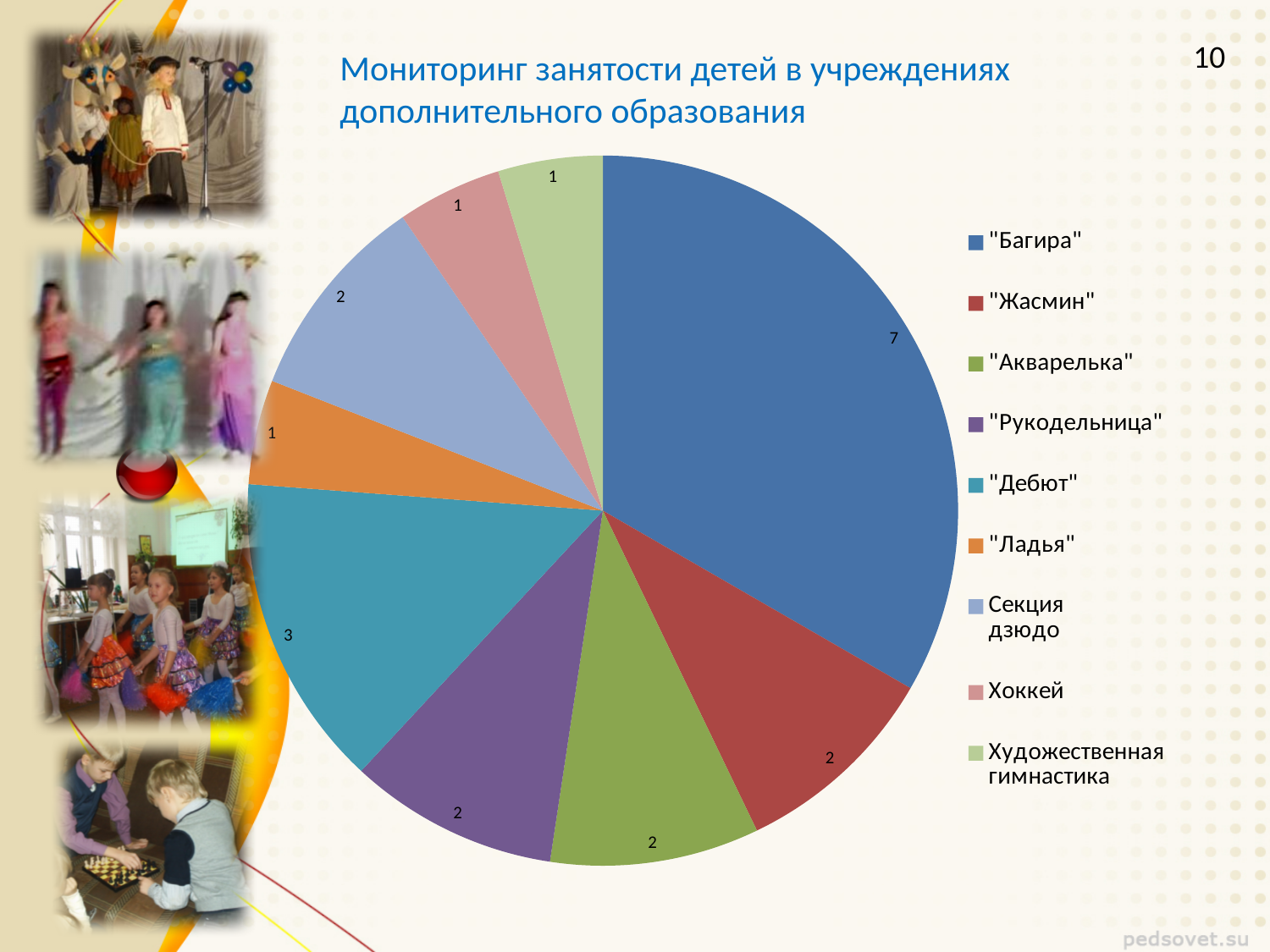
What is the value for "Дебют"? 3 How many categories does the pie chart have? 9 What is the value for "Багира"? 7 Which category has the largest slice of the pie? "Багира" What is the difference between the values for "Багира" and "Дебют"? 4 Which is larger, the value for "Дебют" or the value for "Жасмин"? "Дебют" What is the total of all the values in the pie chart? 21 What is the value for Секция дзюдо? 2 How many categories have a value of 1? 3 What kind of chart is shown on the slide? pie chart What is the title of the chart on the slide? Мониторинг занятости детей в учреждениях дополнительного образования What is the value for "Ладья"? 1